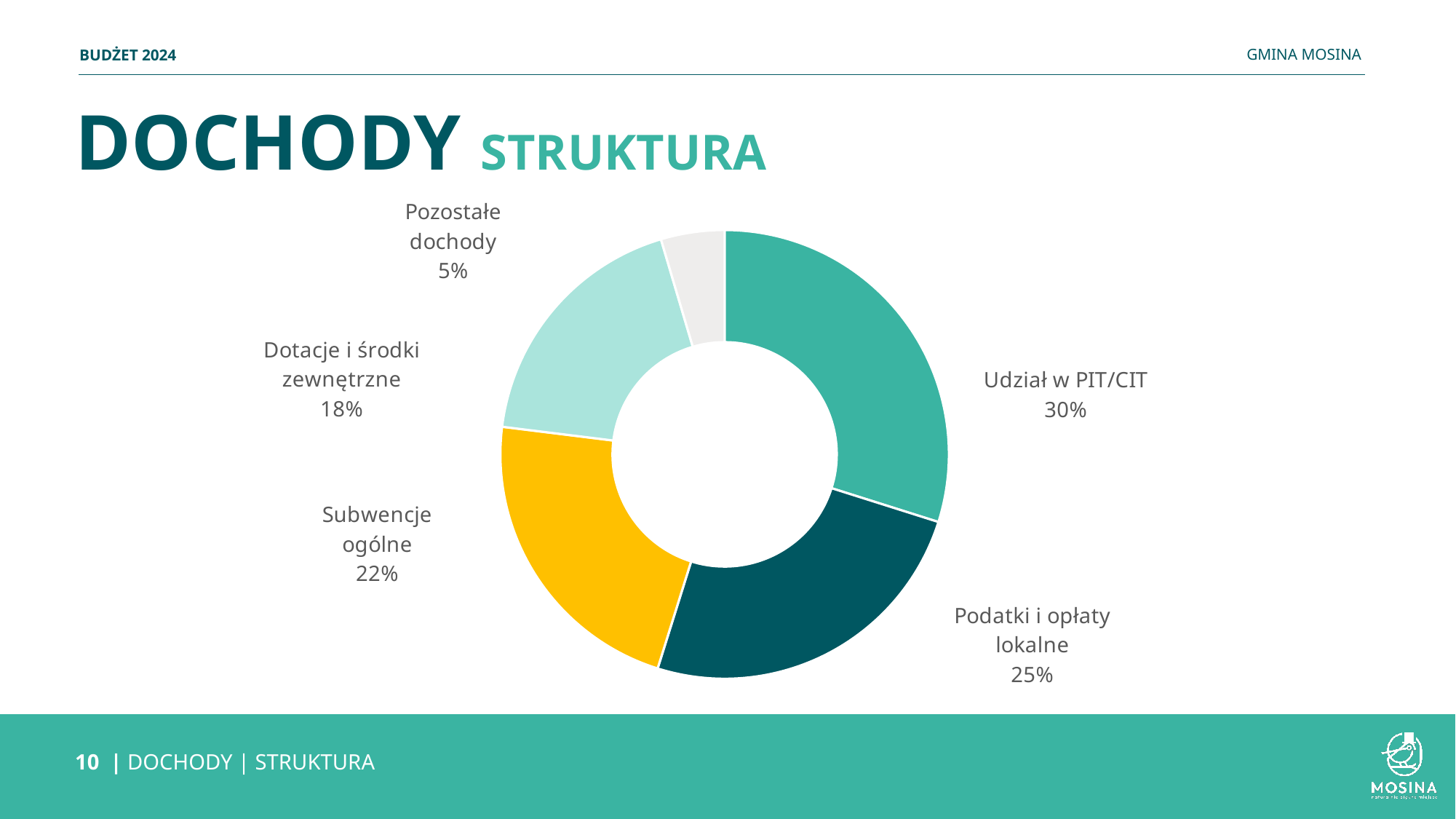
What share of the chart does Dotacje i środki zewnętrzne represent? 18% Which category has the smallest share of the chart? Pozostałe dochody What share of the chart does Pozostałe dochody represent? 5% How many categories are shown in the chart? 5 What kind of chart is shown on the slide? Doughnut (pie) chart What share of the chart does Subwencje ogólne represent? 22% Which category has the largest share of the chart? Udział w PIT/CIT Which is larger, Subwencje ogólne or Dotacje i środki zewnętrzne? Subwencje ogólne What colour is the Subwencje ogólne slice? Yellow What share of the chart does Podatki i opłaty lokalne represent? 25% What is the difference in percentage points between Udział w PIT/CIT and Podatki i opłaty lokalne? 5 What share of the chart does Udział w PIT/CIT represent? 30%